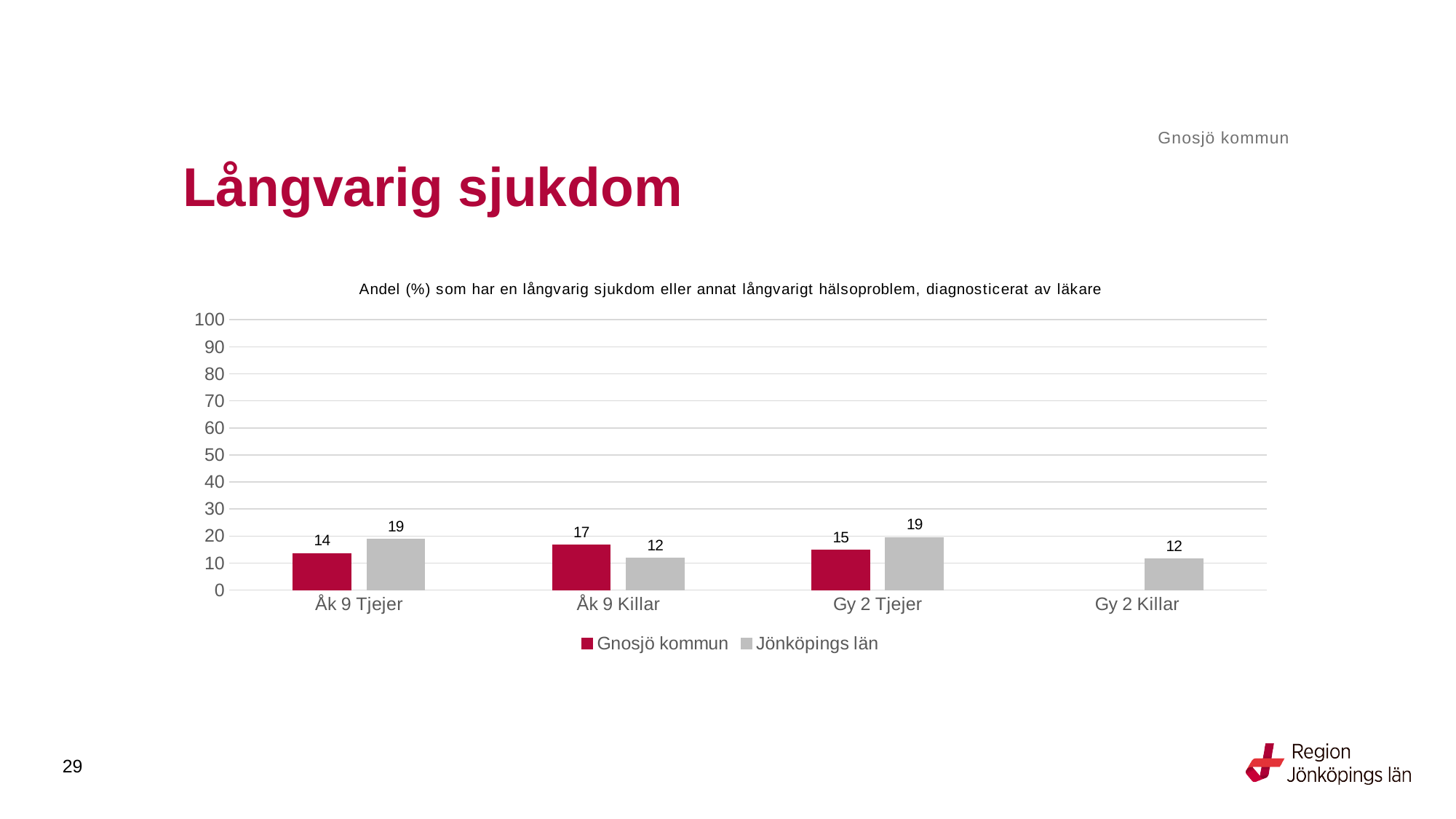
What kind of chart is shown on the slide? bar chart Which category has the highest value for Gnosjö kommun? Åk 9 Killar Which category has the lowest value for Gnosjö kommun among those with a Gnosjö kommun bar? Åk 9 Tjejer What is the value for Gnosjö kommun in the Gy 2 Tjejer category? 15 What is the value for Jönköpings län in the Åk 9 Killar category? 12 How many categories are shown on the x axis? 4 In the Åk 9 Killar category, which series has the larger value, Gnosjö kommun or Jönköpings län? Gnosjö kommun What is the value for Jönköpings län in the Gy 2 Killar category? 12 Is the value for Jönköpings län in Gy 2 Tjejer greater or less than 30? less How many series does the legend list? 2 What is the difference between Jönköpings län and Gnosjö kommun in the Åk 9 Tjejer category? 5 What is the value for Gnosjö kommun in the Åk 9 Tjejer category? 14